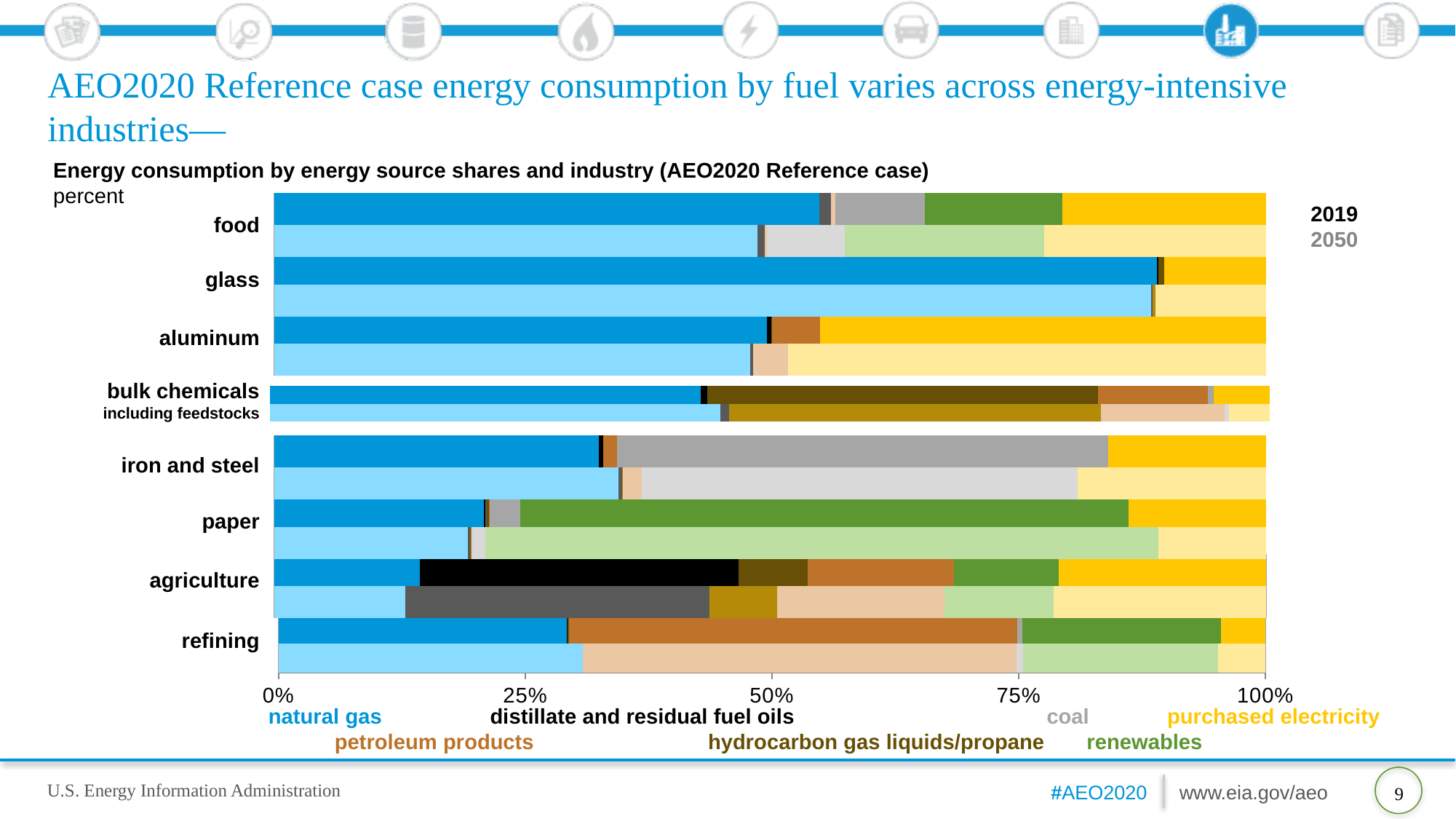
What is the title of the chart? Energy consumption by energy source shares and industry (AEO2020 Reference case) Which industry has the smallest natural gas share in 2019? agriculture Which industry has the larger petroleum products share in 2019, refining or agriculture? refining How many industries are listed on the chart? 8 Is the natural gas share for paper in 2019 greater or less than 25%? less Is the natural gas share for food in 2019 greater or less than 50%? greater Is the coal share for iron and steel in 2019 greater or less than 25%? greater What kind of chart is shown on the slide? stacked bar chart Which two years are compared for each industry on the chart? 2019 and 2050 How many energy sources does the legend list? 7 Which industry has the largest natural gas share in 2019? glass